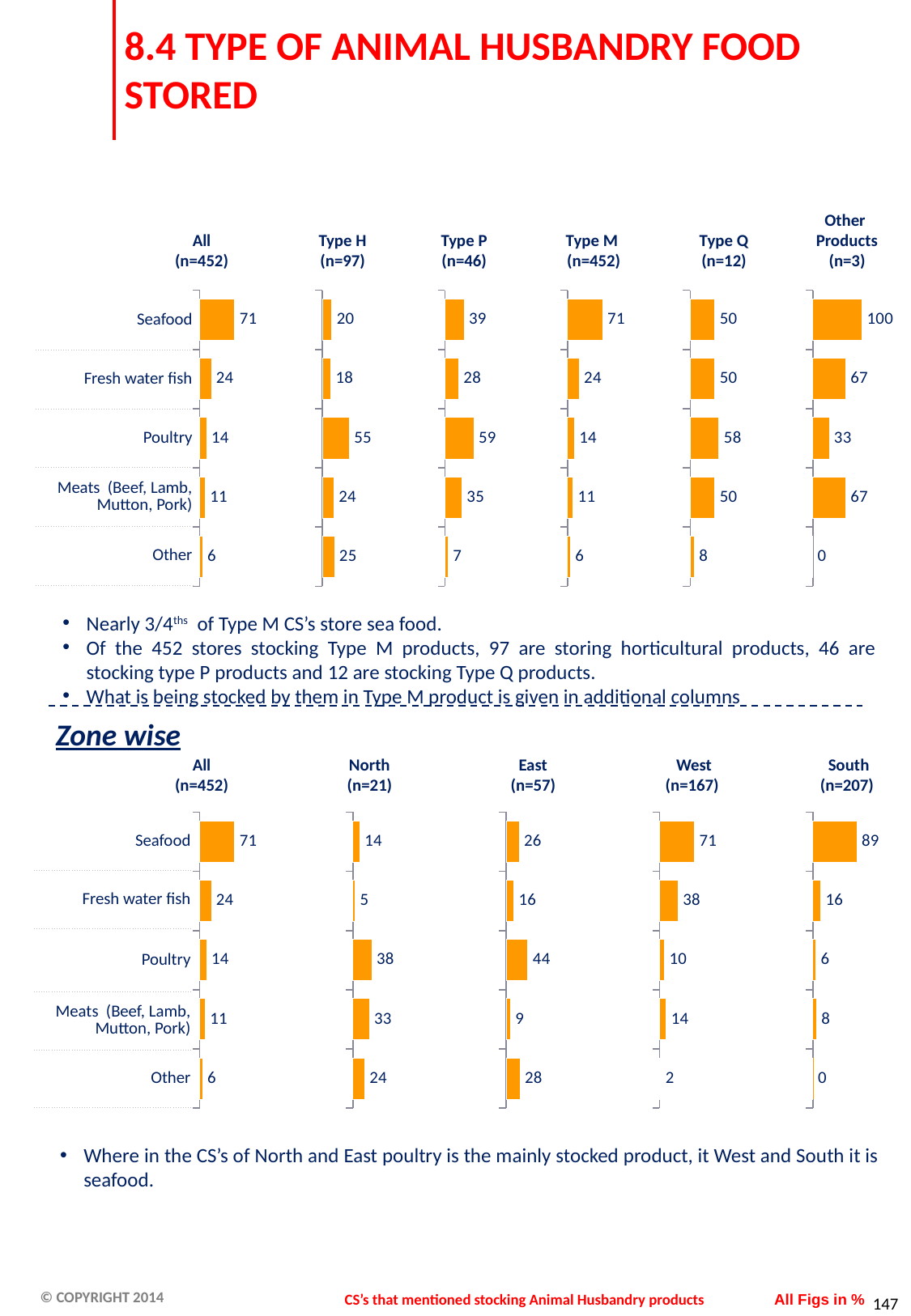
In the top set of charts, what is the value for Poultry in the Type P (n=46) chart? 59 In the top set of charts, which category has the lowest value in the Type Q (n=12) chart? Other In the Zone wise set of charts, what is the value for Seafood in the South (n=207) chart? 89 In the top set of charts, what is the value for Seafood in the Type H (n=97) chart? 20 In the Zone wise set of charts, what is the difference between Fresh water fish in the West (n=167) chart and Fresh water fish in the North (n=21) chart? 33 In the top set of charts, which is larger: Poultry in the Type H (n=97) chart or Poultry in the Type M (n=452) chart? Type H In the Zone wise set of charts, what is the value for Other in the West (n=167) chart? 2 How many categories are shown in each chart of the Zone wise set? 5 What type of chart is used on this slide? Bar chart In the Zone wise set of charts, which category has the highest value in the East (n=57) chart? Poultry In the top set of charts, what is the difference between the Seafood values in the All (n=452) chart and the Type P (n=46) chart? 32 In the top set of charts, which category has the highest value in the Other Products (n=3) chart? Seafood